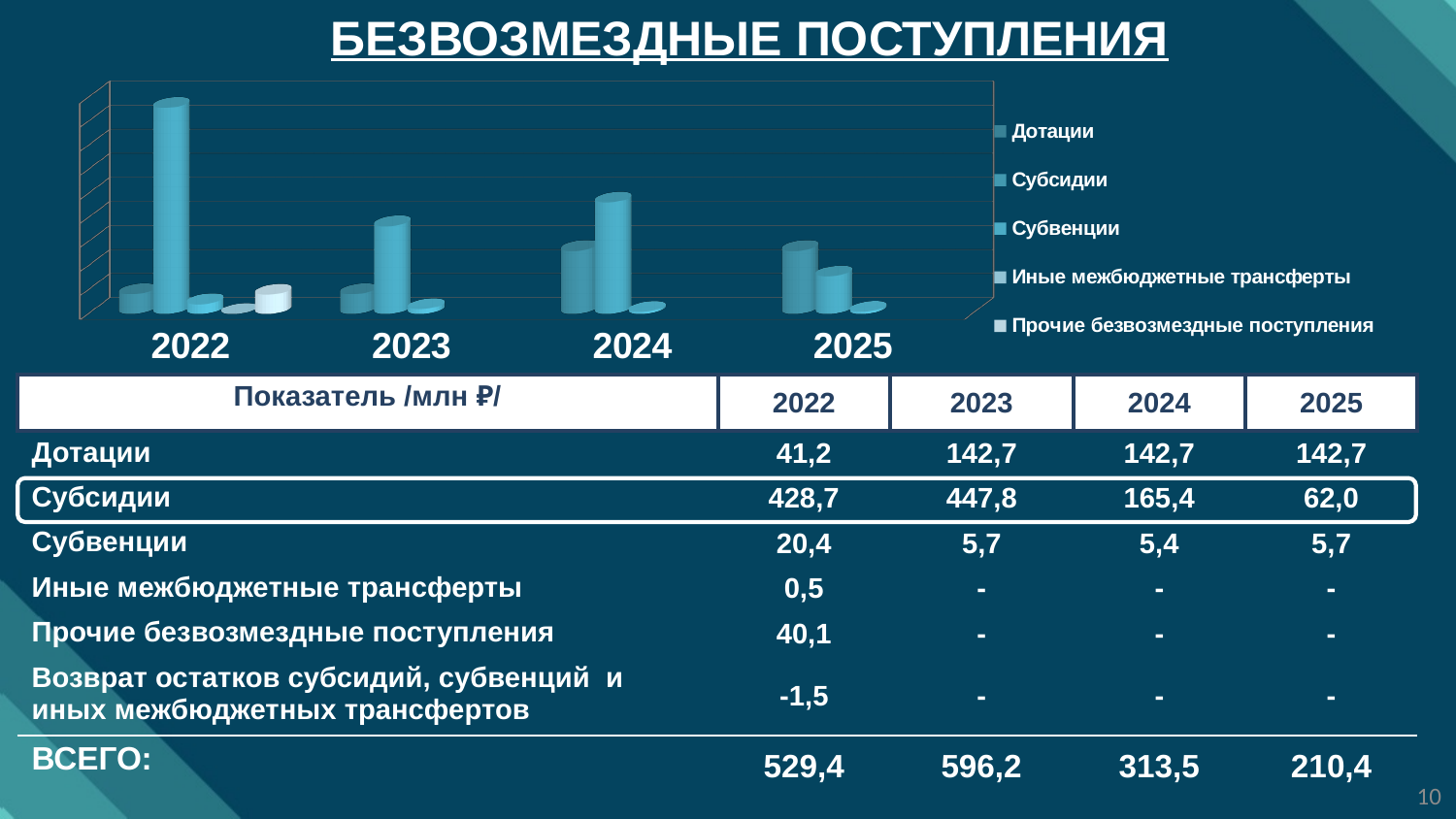
Which is larger in 2025, Дотации or Субсидии? Дотации How many series does the chart legend list? 5 Do the Субсидии values rise or fall from 2023 to 2025? fall In which year is the value of Субсидии the highest? 2023 In which year is the value of Субсидии the lowest? 2025 What is the title of the slide's chart? БЕЗВОЗМЕЗДНЫЕ ПОСТУПЛЕНИЯ What is the difference between the Субсидии values for 2023 and 2022? 19,1 What kind of chart is shown on the slide? bar chart What is the value of Субсидии for 2023? 447,8 What is the value of Дотации for 2022? 41,2 How many years (categories) are shown on the x axis of the chart? 4 What is the value of Субвенции for 2024? 5,4